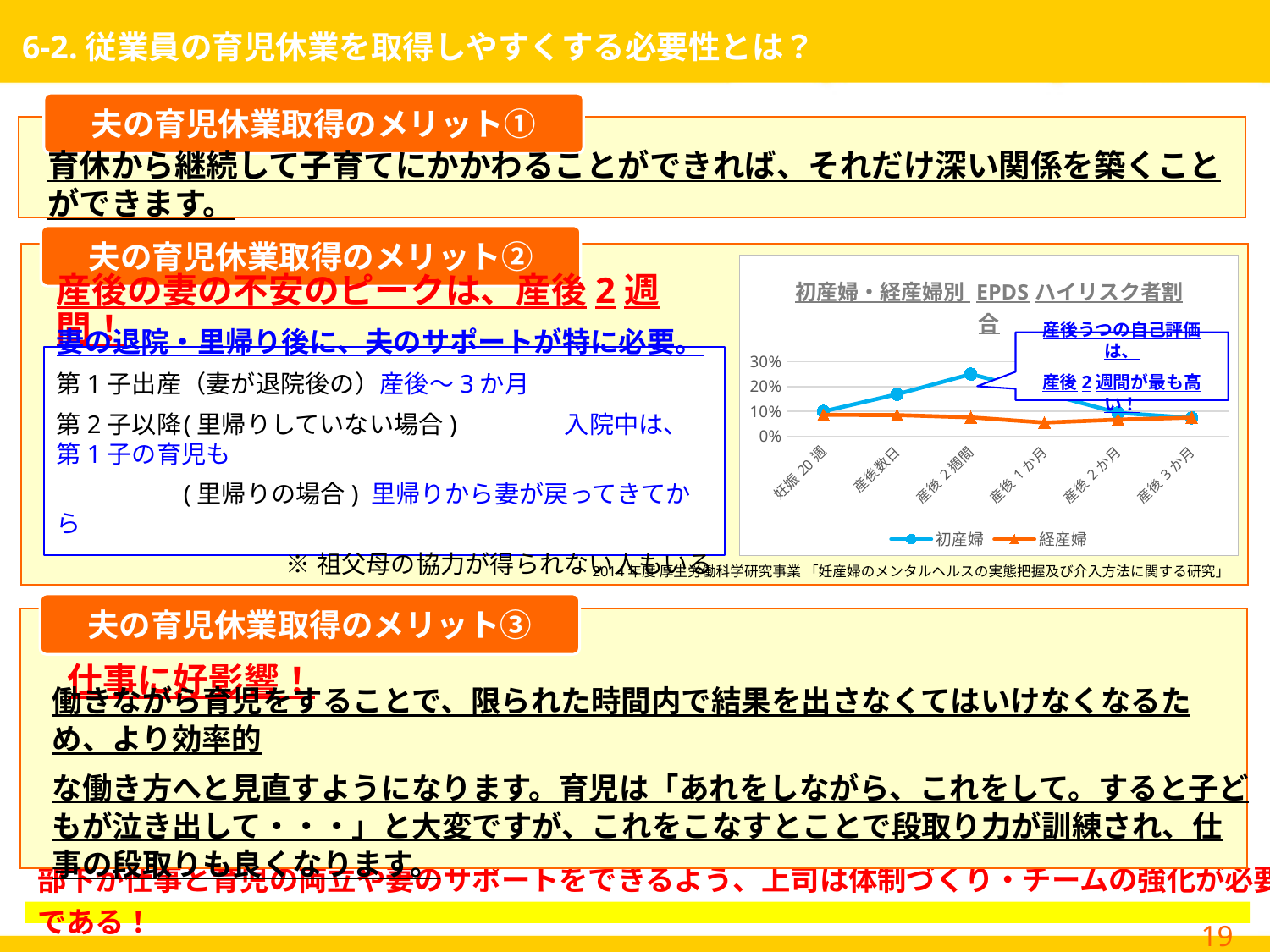
Does the 初産婦 series rise or fall from 妊娠20週 to 産後2週間? rise At which time point does the 初産婦 series reach its highest value? 産後2週間 What is the title of the chart on the slide? 初産婦・経産婦別 EPDS ハイリスク者割合 At 産後2週間, which series has the larger value, 初産婦 or 経産婦? 初産婦 Does the 初産婦 series rise or fall from 産後2週間 to 産後1か月? fall Is the value for 初産婦 at 産後数日 greater or less than 10%? greater Is the value for 初産婦 at 産後2週間 greater or less than 20%? greater Which two series are listed in the chart's legend? 初産婦 and 経産婦 What kind of chart is shown on the slide? line chart Is the value for 経産婦 at 産後1か月 greater or less than 10%? less How many time points are plotted along the x axis of the chart? 6 How many series does the chart's legend list? 2